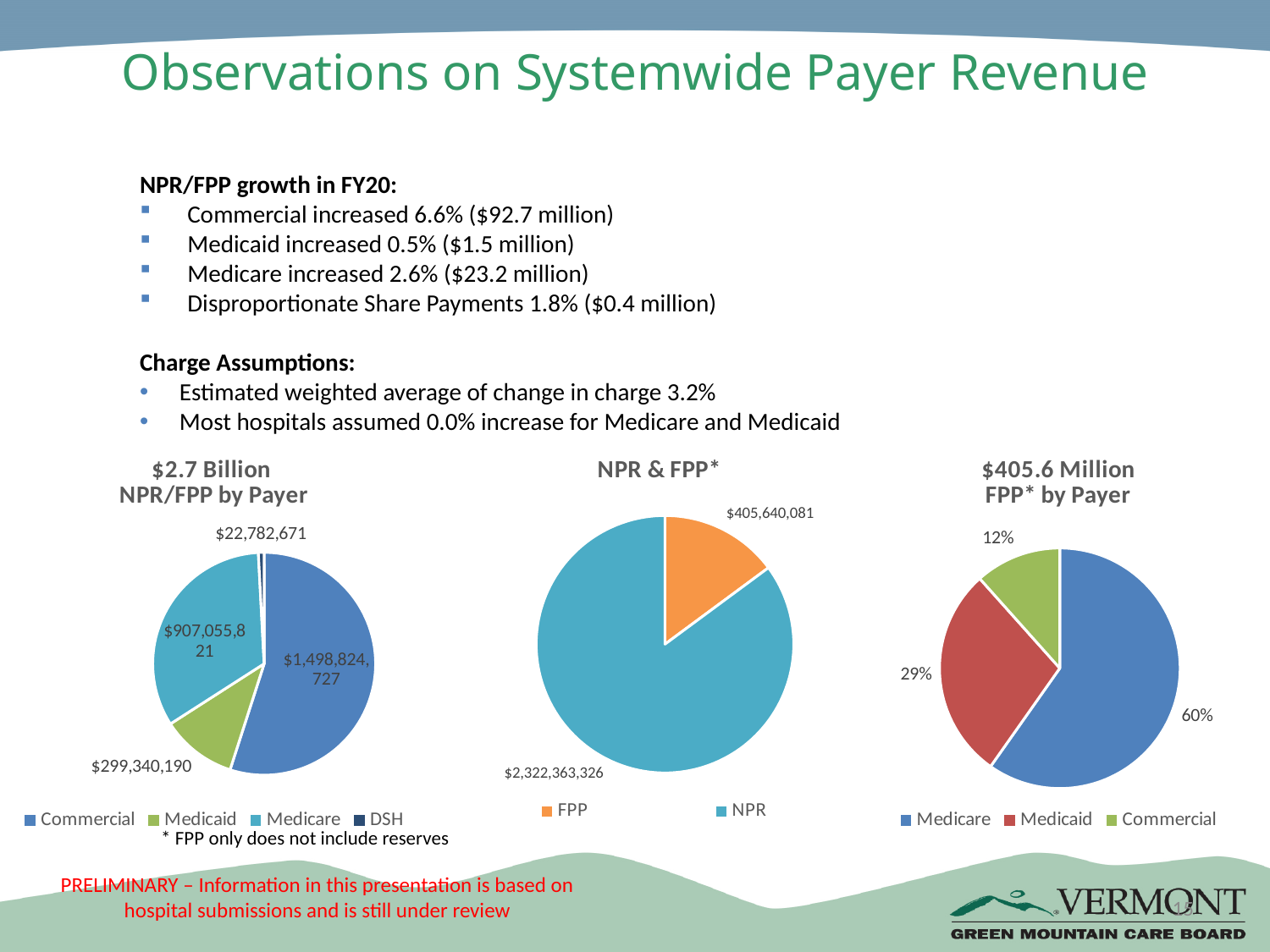
In the "$405.6 Million FPP* by Payer" chart, what share does Medicaid have? 29% In the "$2.7 Billion NPR/FPP by Payer" chart, what is the value for DSH? $22,782,671 In the "NPR & FPP*" chart, what is the value for FPP? $405,640,081 In the "$405.6 Million FPP* by Payer" chart, what share does Medicare have? 60% In the "$2.7 Billion NPR/FPP by Payer" chart, what is the value for Medicare? $907,055,821 In the "$405.6 Million FPP* by Payer" chart, which payer has the largest share? Medicare In the "NPR & FPP*" chart, what is the value for NPR? $2,322,363,326 In the "$2.7 Billion NPR/FPP by Payer" chart, how many payer categories does the legend list? 4 In the "$2.7 Billion NPR/FPP by Payer" chart, what is the value for Commercial? $1,498,824,727 In the "NPR & FPP*" chart, which is larger, NPR or FPP? NPR In the "$2.7 Billion NPR/FPP by Payer" chart, which payer has the smallest slice? DSH What kind of chart is the "NPR & FPP*" chart? Pie chart